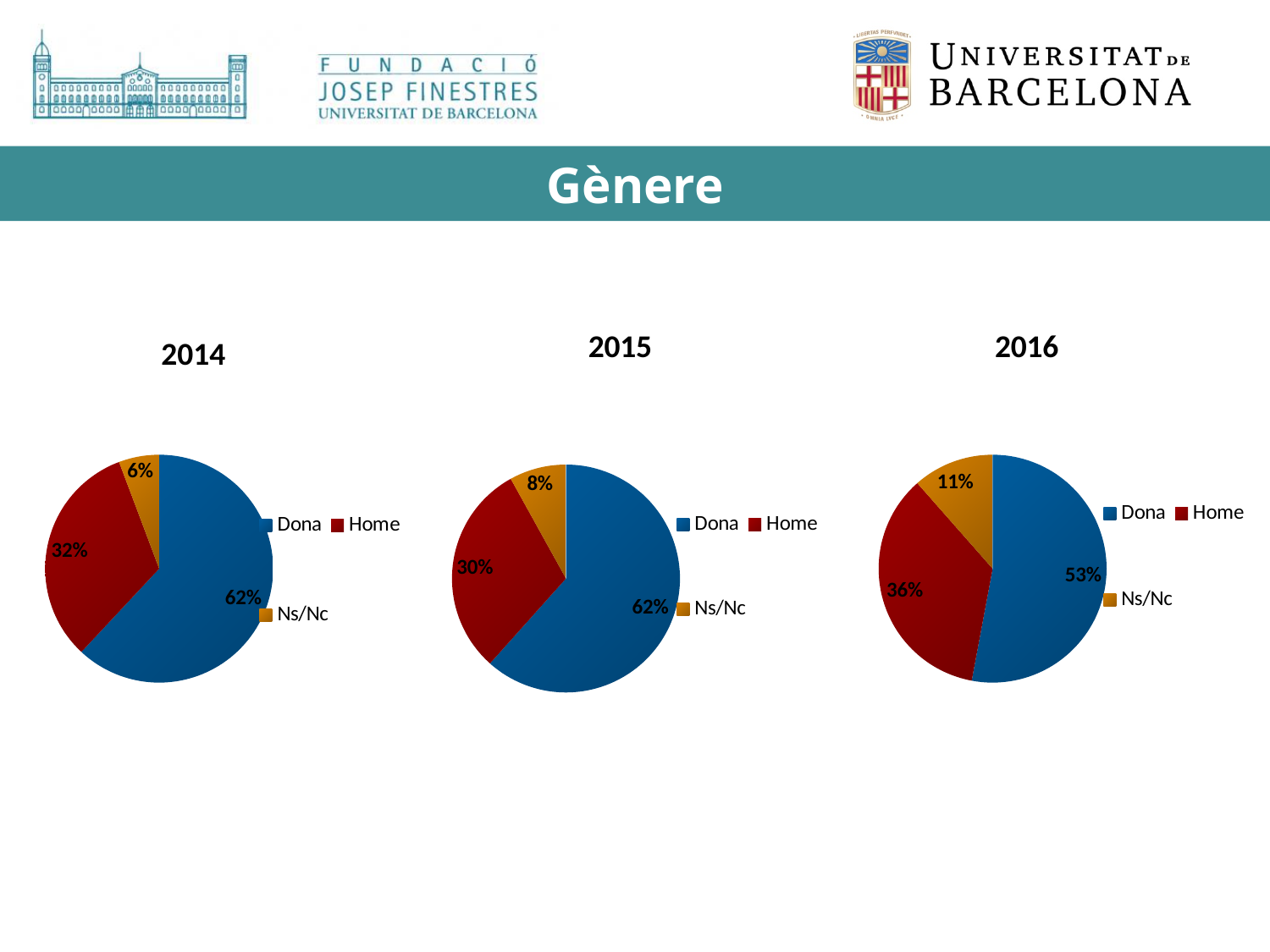
In the 2014 chart, what percentage is shown for Dona? 62% In the 2014 chart, what percentage is shown for Home? 32% In the 2016 chart, what percentage is shown for Home? 36% What kind of chart is the 2014 chart? Pie chart In the 2016 chart, what percentage is shown for Dona? 53% In the 2015 chart, which category has the largest slice? Dona How many categories does the legend of the 2016 chart list? 3 In the 2015 chart, what percentage is shown for Ns/Nc? 8% What is the title of the 2015 chart? 2015 In the 2015 chart, which is larger, Home or Ns/Nc? Home In the 2016 chart, what is the difference between the Dona and Home percentages? 17% In the 2014 chart, which category has the smallest slice? Ns/Nc